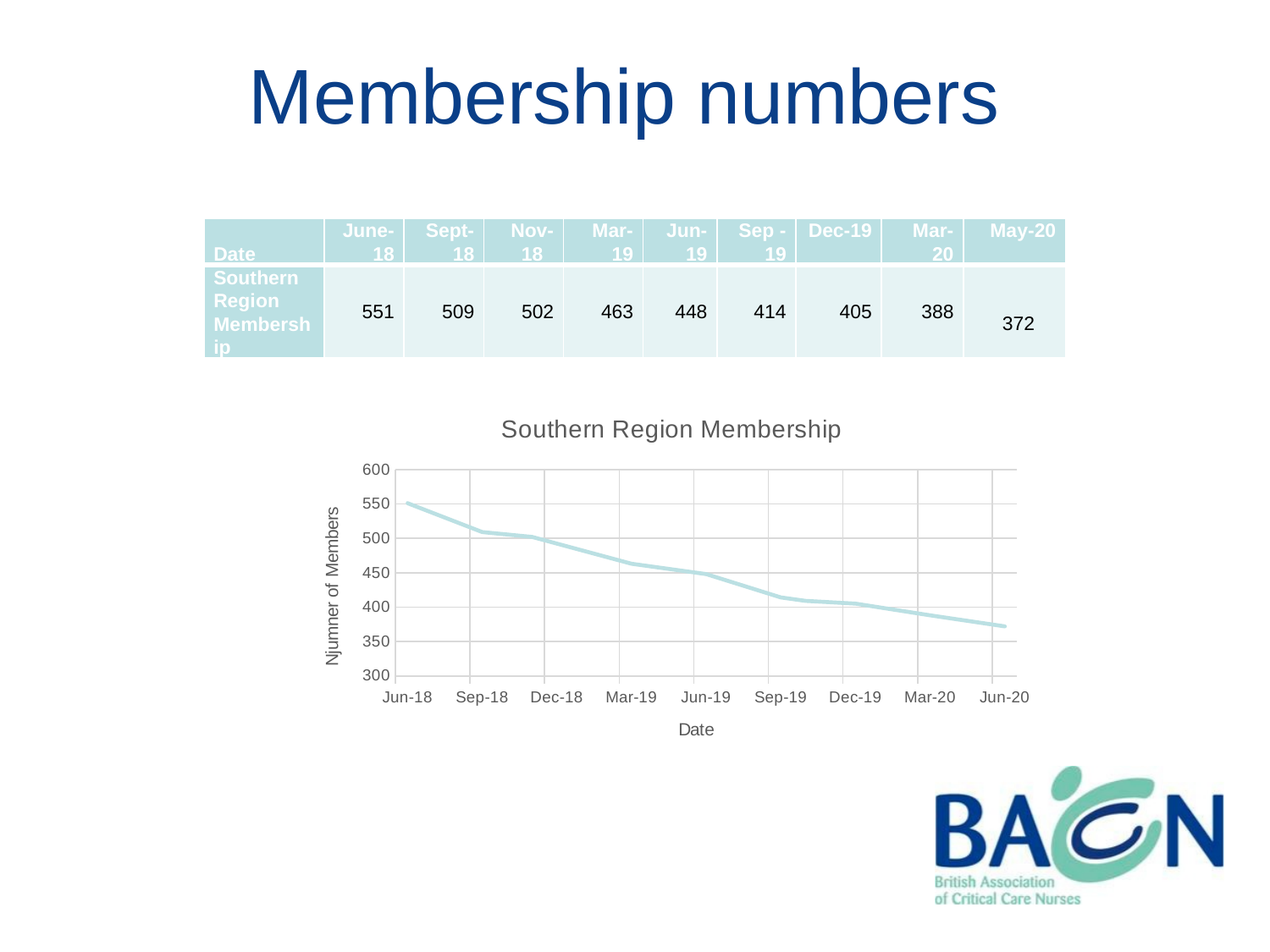
At which date is the Southern Region Membership lowest? Jun-20 What is the title of the chart on the slide? Southern Region Membership Is the Southern Region Membership value at Jun-18 greater or less than 500? greater What is the label on the y axis of the Southern Region Membership chart? Njumner of Members Is the Southern Region Membership value at Sep-19 greater or less than 450? less At which date is the Southern Region Membership highest? Jun-18 What kind of chart is the Southern Region Membership chart? line chart Is the Southern Region Membership value at Jun-20 greater or less than 400? less How many dates are labelled on the x axis of the Southern Region Membership chart? 9 According to the table, what was the Southern Region Membership in June-18? 551 Which is larger, the Southern Region Membership at Mar-19 or at Dec-19? Mar-19 Do the values in the Southern Region Membership chart rise or fall along the x axis? fall